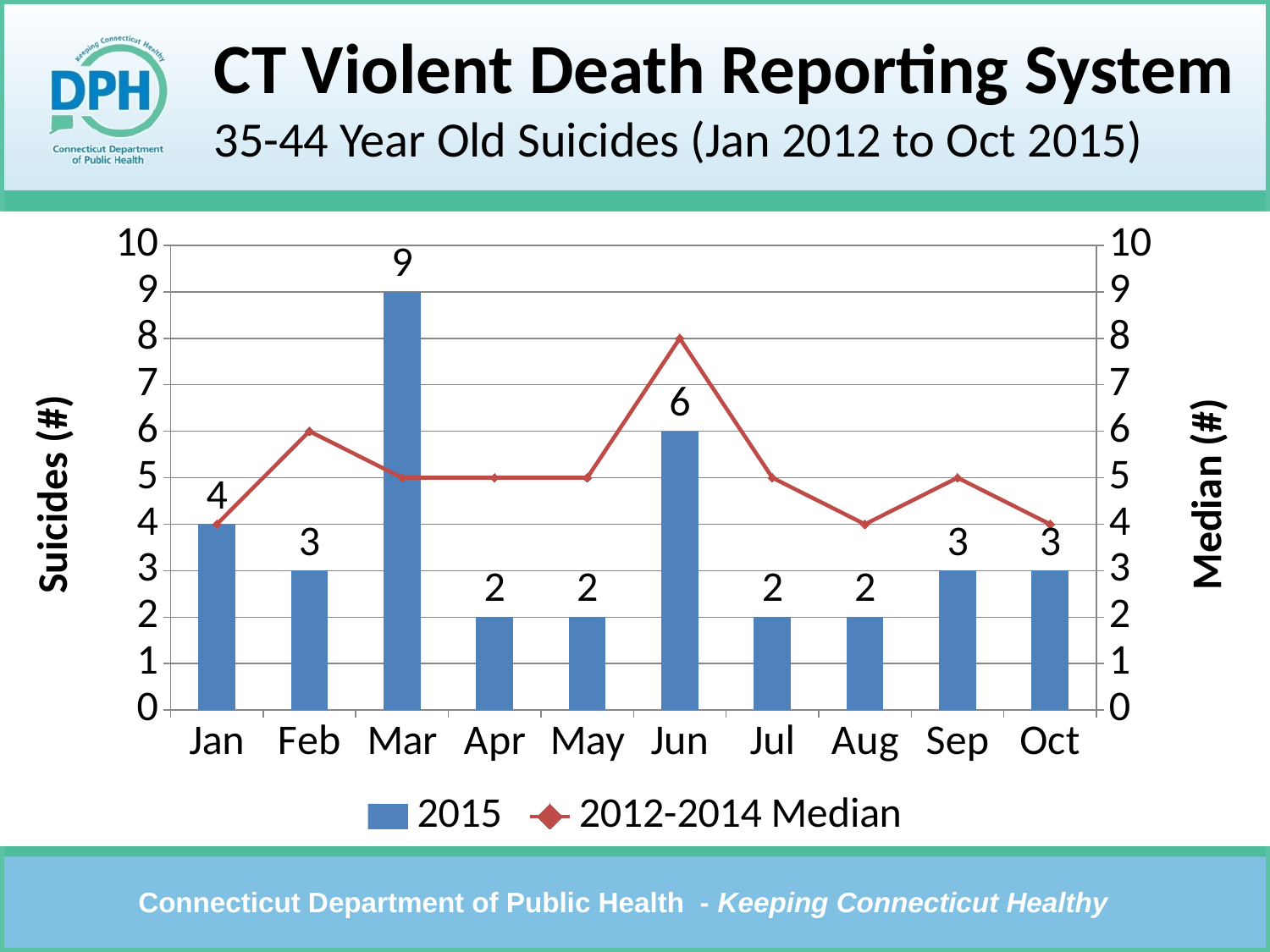
Is the 2012-2014 Median value for Aug greater or less than 5? less What is the 2015 value for Jun? 6 What is the label of the right-hand vertical axis? Median (#) Is the 2012-2014 Median value for Jun greater or less than 7? greater What is the 2015 value for Jan? 4 What is the difference between the 2015 values for Mar and Jun? 3 What is the 2015 value for Mar? 9 How many months are shown on the x axis? 10 Which month has the highest 2015 value? Mar What kind of chart is used for the 2015 series? Bar chart Which is larger, the 2015 value for Feb or the 2015 value for Apr? Feb How many series does the legend list? 2